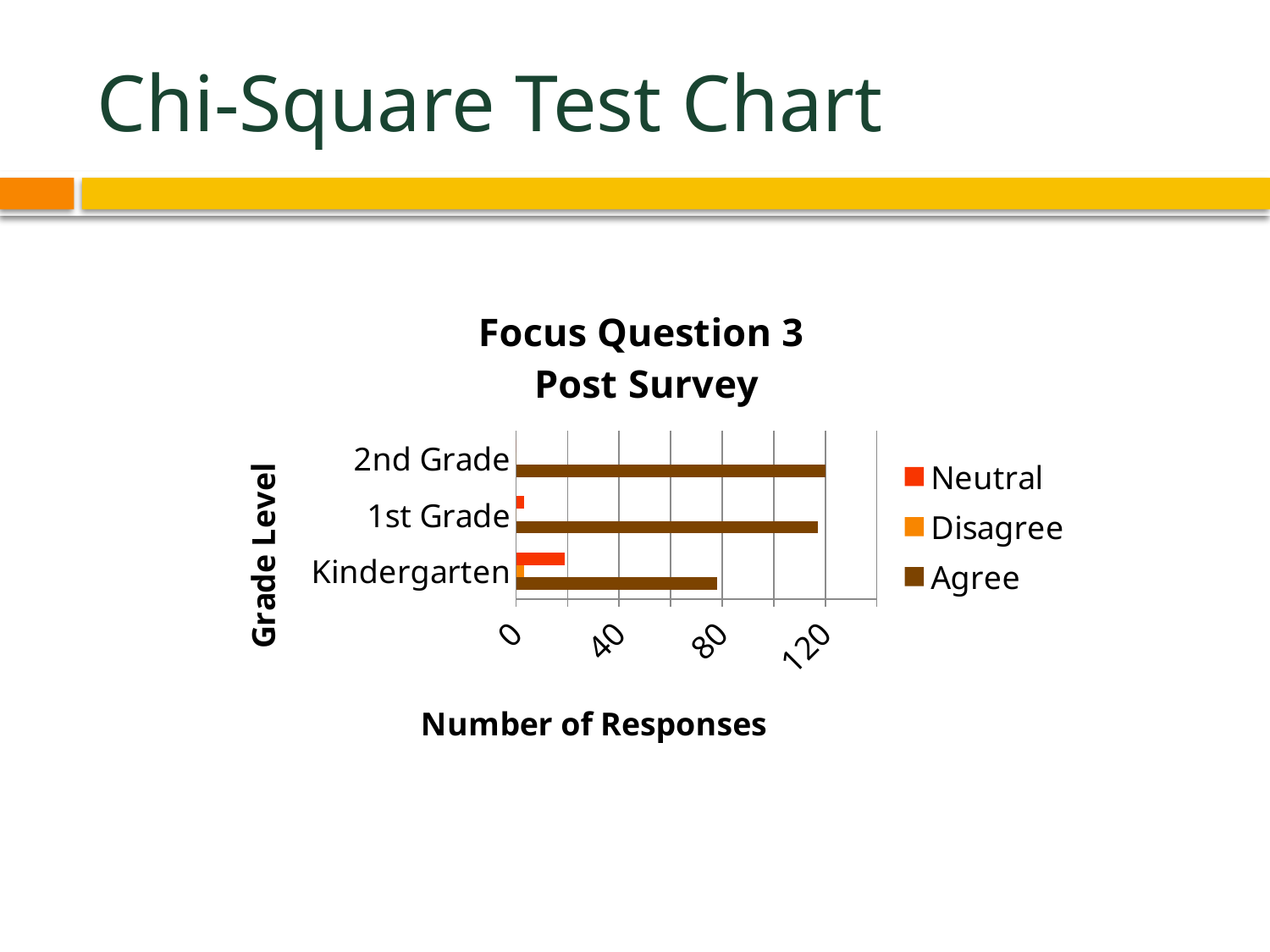
Is the Neutral value for Kindergarten greater or less than 40? less What is the label of the horizontal axis of the chart? Number of Responses Is the Agree value for 2nd Grade greater or less than 80? greater Which is larger, the Agree value for Kindergarten or the Agree value for 1st Grade? 1st Grade What kind of chart is shown on the slide? bar chart Is the Agree value for Kindergarten greater or less than 40? greater How many series does the chart's legend list? 3 What is the title of the chart? Focus Question 3 Post Survey Which grade level has the lowest Agree value? Kindergarten How many grade levels are shown on the chart? 3 Which is larger for Kindergarten, the Neutral value or the Disagree value? Neutral